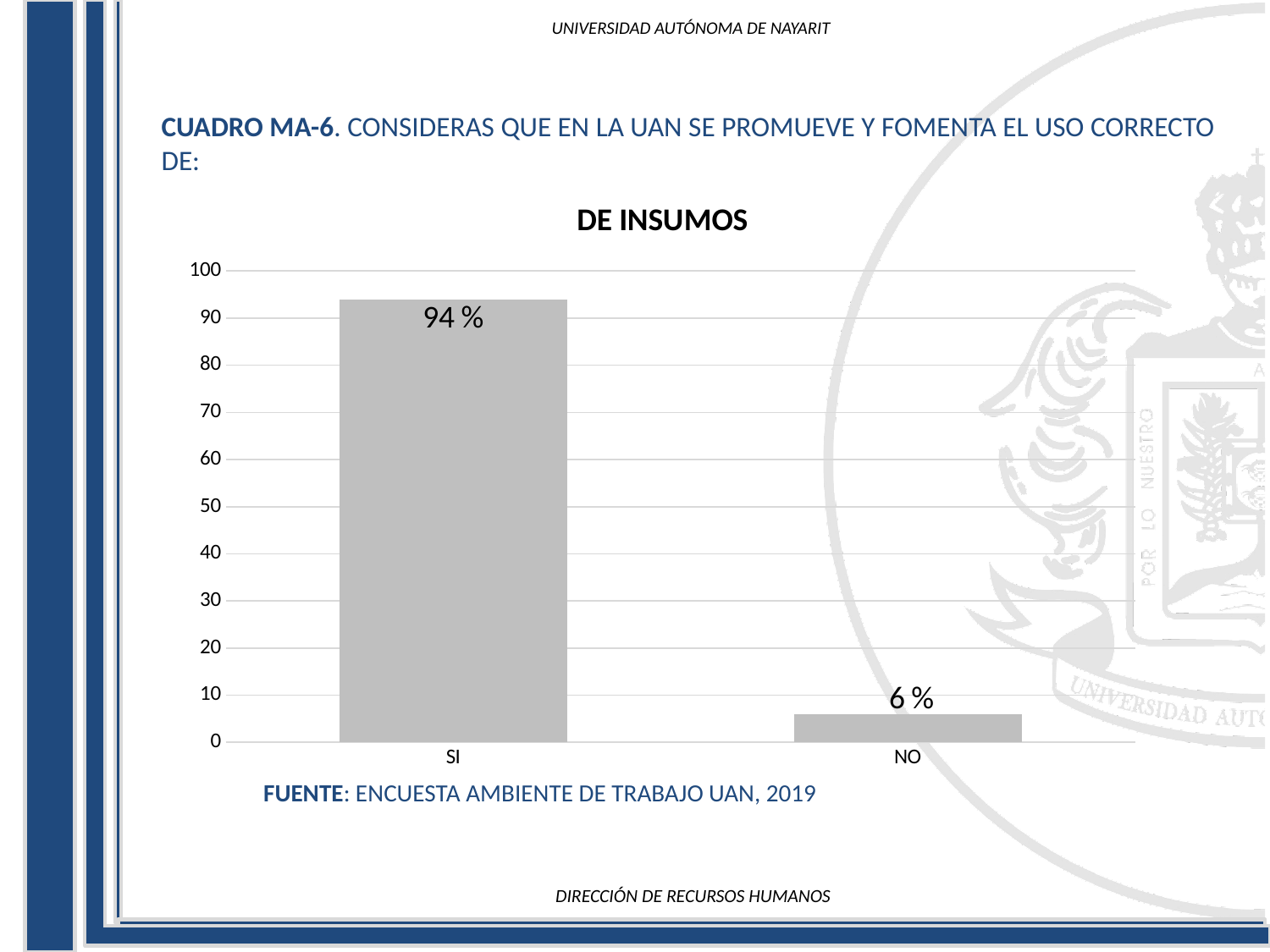
What kind of chart is shown on the slide? bar chart What is the value for SI? 94 % How many categories are shown on the x axis? 2 Is the value for SI greater or less than 90? greater What is the difference between the values for SI and NO? 88 % Which is larger, the value for SI or the value for NO? SI What is the value for NO? 6 % Is the value for NO greater or less than 10? less What is the highest value shown on the y axis? 100 Which category has the lowest value? NO What is the title of the chart? DE INSUMOS Which category has the highest value? SI